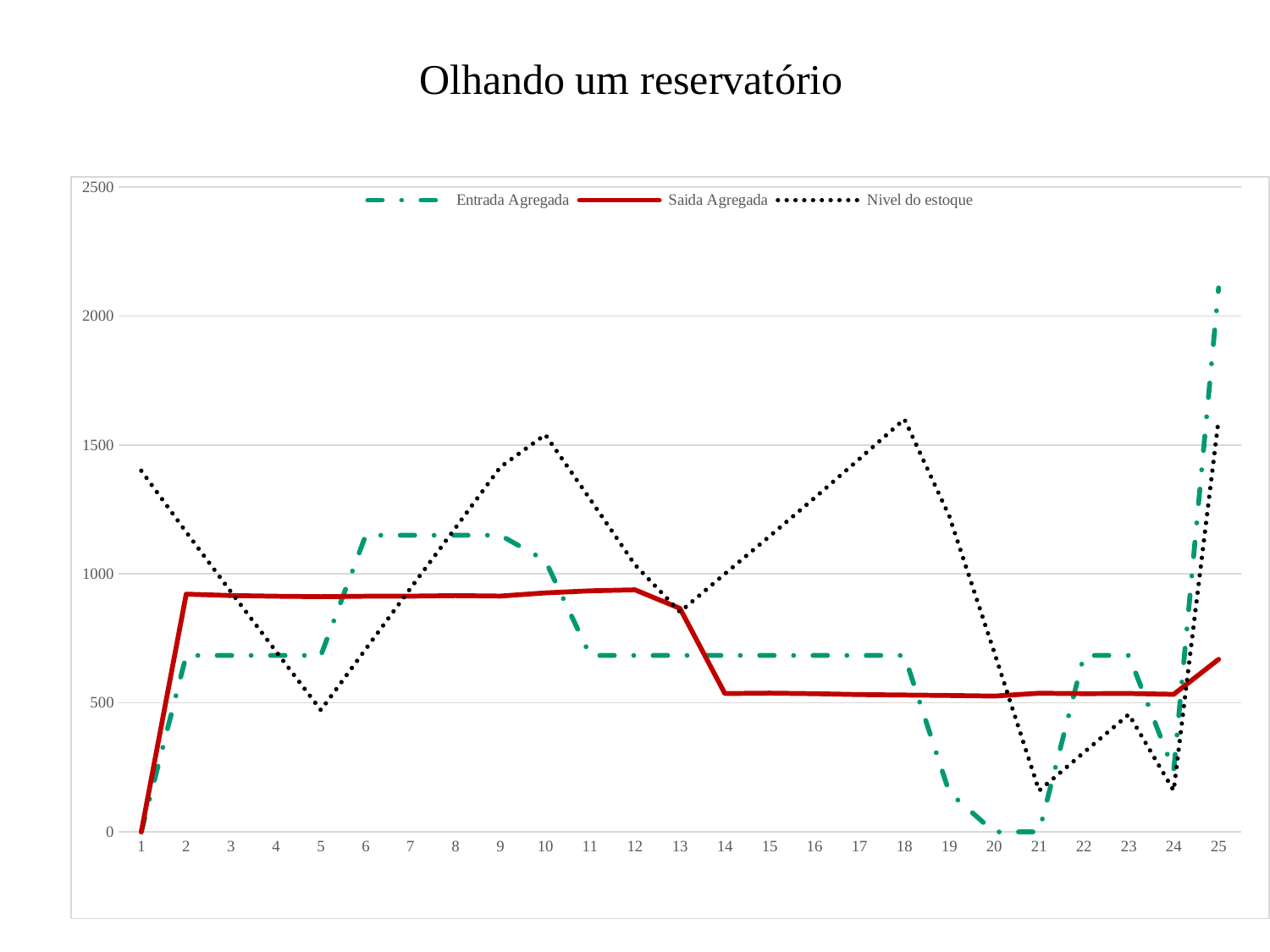
How many points are on the x axis of the chart? 25 What is the value of Entrada Agregada at point 20? 0 At which point does Entrada Agregada reach its highest value? 25 What is the value of Saida Agregada at point 1? 0 Is the value of Nivel do estoque at point 18 greater or less than 1500? greater Is the value of Nivel do estoque at point 21 greater or less than 500? less What kind of chart is shown on the slide? line chart At point 18, which series has the larger value, Nivel do estoque or Saida Agregada? Nivel do estoque Which series is drawn with a black dotted line? Nivel do estoque What is the title of the slide? Olhando um reservatório Is the value of Entrada Agregada at point 25 greater or less than 2000? greater How many series does the legend list? 3